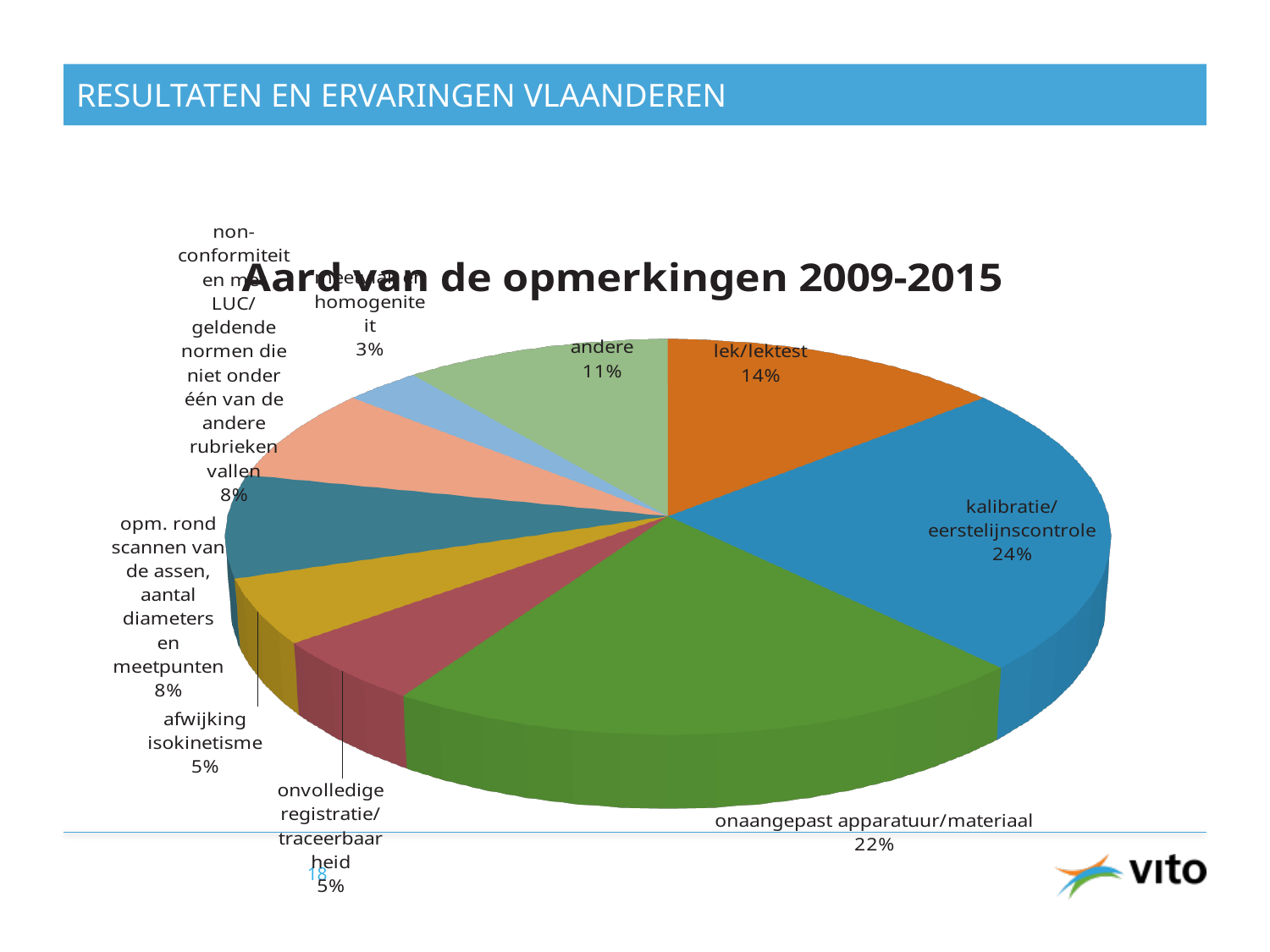
What percentage is shown for lek/lektest? 14% What share of the pie does kalibratie/eerstelijnscontrole represent? 24% What percentage is shown for onaangepast apparatuur/materiaal? 22% What is the difference in percentage points between kalibratie/eerstelijnscontrole and lek/lektest? 10 How many slices does the pie chart have? 9 What is the title of the chart? Aard van de opmerkingen 2009-2015 What is the smallest percentage shown on the pie chart? 3% What percentage is shown for afwijking isokinetisme? 5% Which is larger: the share for onaangepast apparatuur/materiaal or the share for andere? onaangepast apparatuur/materiaal What kind of chart is shown on the slide? pie chart Which category has the largest share of the pie? kalibratie/eerstelijnscontrole What share does the 'andere' slice have? 11%